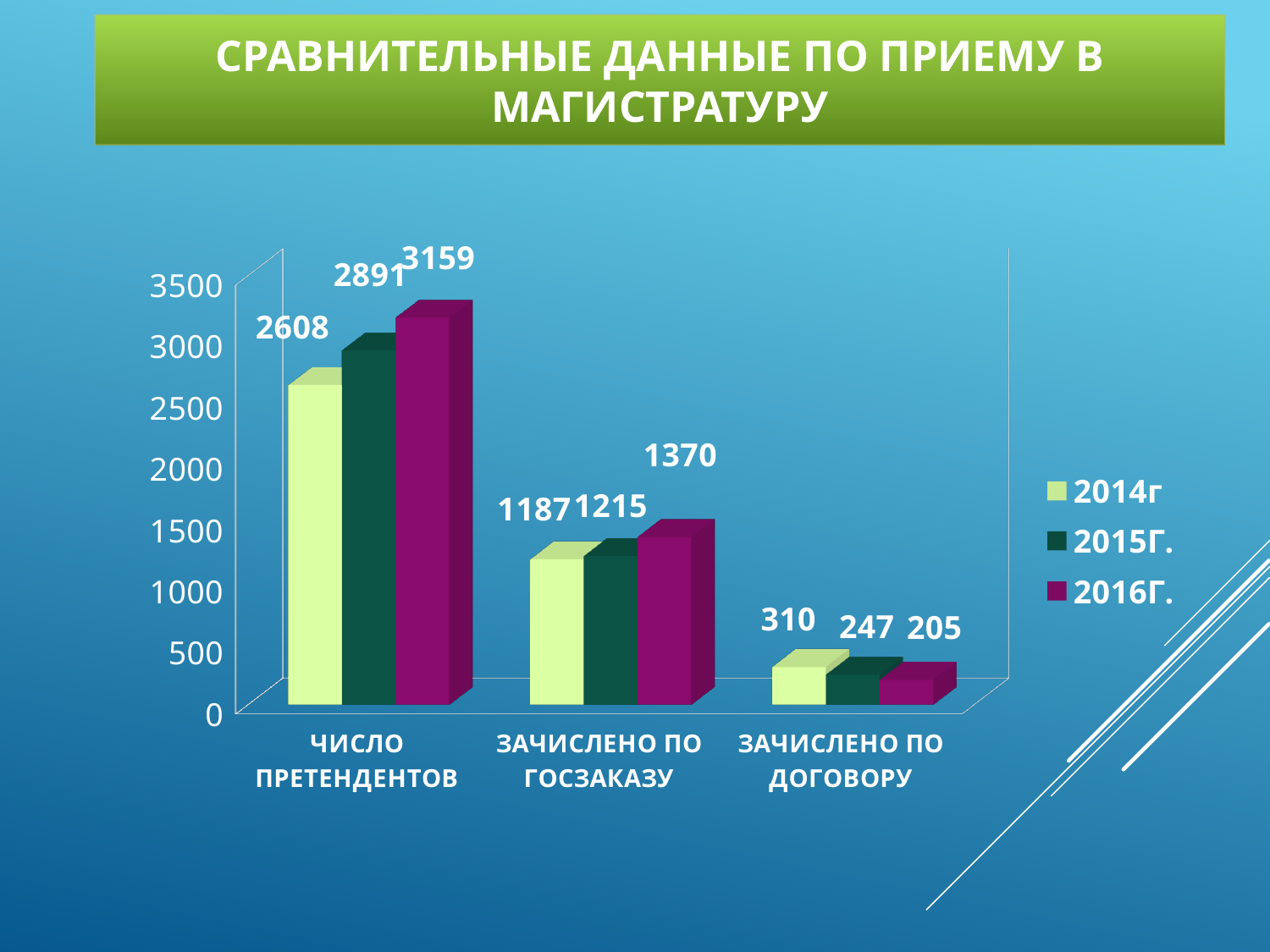
What is the value for ЗАЧИСЛЕНО ПО ДОГОВОРУ in 2015Г.? 247 What is the value for ЗАЧИСЛЕНО ПО ГОСЗАКАЗУ in 2014г? 1187 Do the values for ЗАЧИСЛЕНО ПО ДОГОВОРУ rise or fall from 2014г to 2016Г.? fall Which category has the highest value for 2014г? ЧИСЛО ПРЕТЕНДЕНТОВ What is the value for ЧИСЛО ПРЕТЕНДЕНТОВ in 2016Г.? 3159 Which is larger for ЗАЧИСЛЕНО ПО ГОСЗАКАЗУ: the 2015Г. value or the 2016Г. value? 2016Г. How many series does the legend list? 3 How many categories are shown on the x axis? 3 What is the difference between the 2014г and 2016Г. values for ЗАЧИСЛЕНО ПО ДОГОВОРУ? 105 What is the difference between the 2016Г. and 2014г values for ЧИСЛО ПРЕТЕНДЕНТОВ? 551 What kind of chart is shown on the slide? bar chart Which category has the lowest value for 2016Г.? ЗАЧИСЛЕНО ПО ДОГОВОРУ